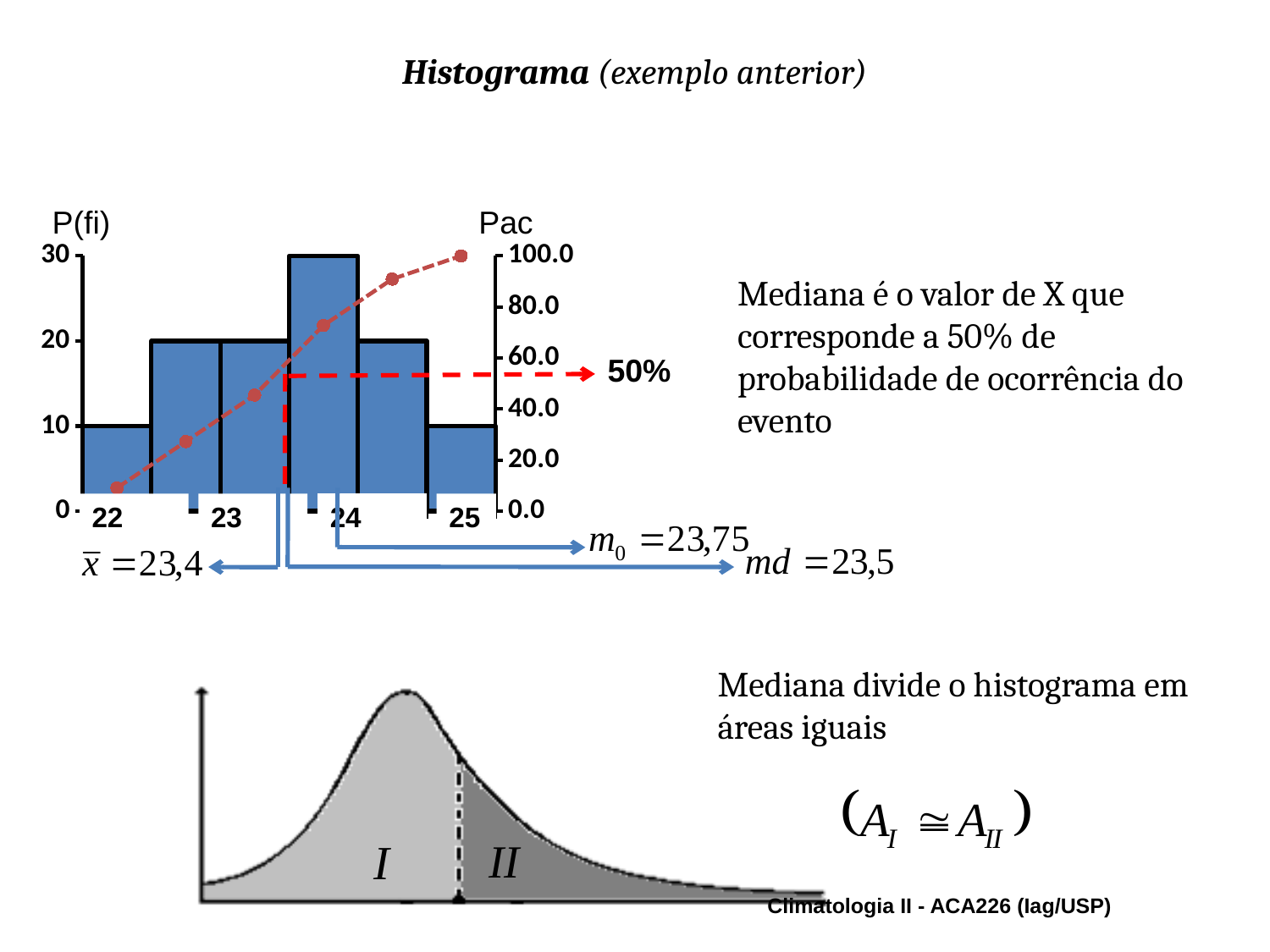
What is the median (md) value indicated below the top histogram? 23,5 What labels are given to the two shaded areas in the bottom chart? I and II In the top histogram, what is the value of the tallest bar on the left P(fi) axis? 30 What kind of chart is the top chart on the slide (the histogram)? bar chart How many bars does the top histogram have? 6 In the top histogram, is the first bar on the left taller or shorter than the second bar? shorter In the top histogram, how many bars reach the value 20 on the P(fi) axis? 3 In the top histogram, what is the difference between the tallest bar and the shortest bar on the P(fi) axis? 20 In the top chart, does the dashed cumulative line (Pac) rise or fall from left to right? rises In the top chart, is the last (rightmost) point of the cumulative Pac line greater or less than 80.0? greater In the top histogram, what is the value of the shortest bars on the left P(fi) axis? 10 In the top chart, is the first (leftmost) point of the cumulative Pac line greater or less than 20.0? less